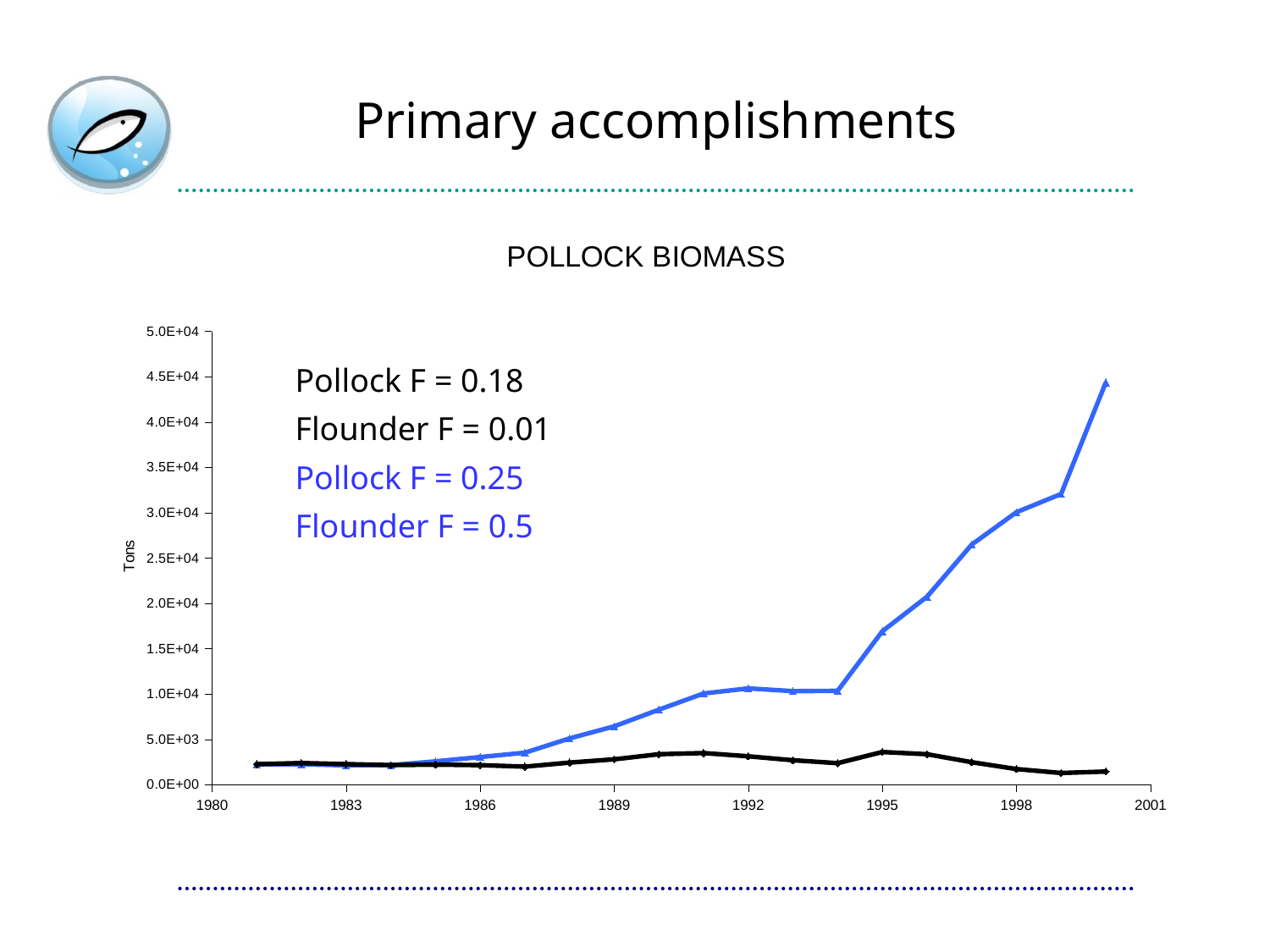
In which year does the blue line reach its highest value? 2000 Is the value of the black line in 2000 greater or less than 5.0E+03? less What is the title of the chart? POLLOCK BIOMASS Is the value of the blue line in 1997 greater or less than 2.5E+04? greater Is the value of the blue line in 2000 greater or less than 4.0E+04? greater Does the black line (Pollock F = 0.18, Flounder F = 0.01) rise or fall from 1995 to 2000? fall In 2000, which line has the larger value, the blue line or the black line? the blue line What kind of chart is shown on the slide? line chart How many lines are plotted on the chart? 2 What is the label on the vertical axis of the chart? Tons Does the blue line (Pollock F = 0.25, Flounder F = 0.5) rise or fall from 1994 to 2000? rise